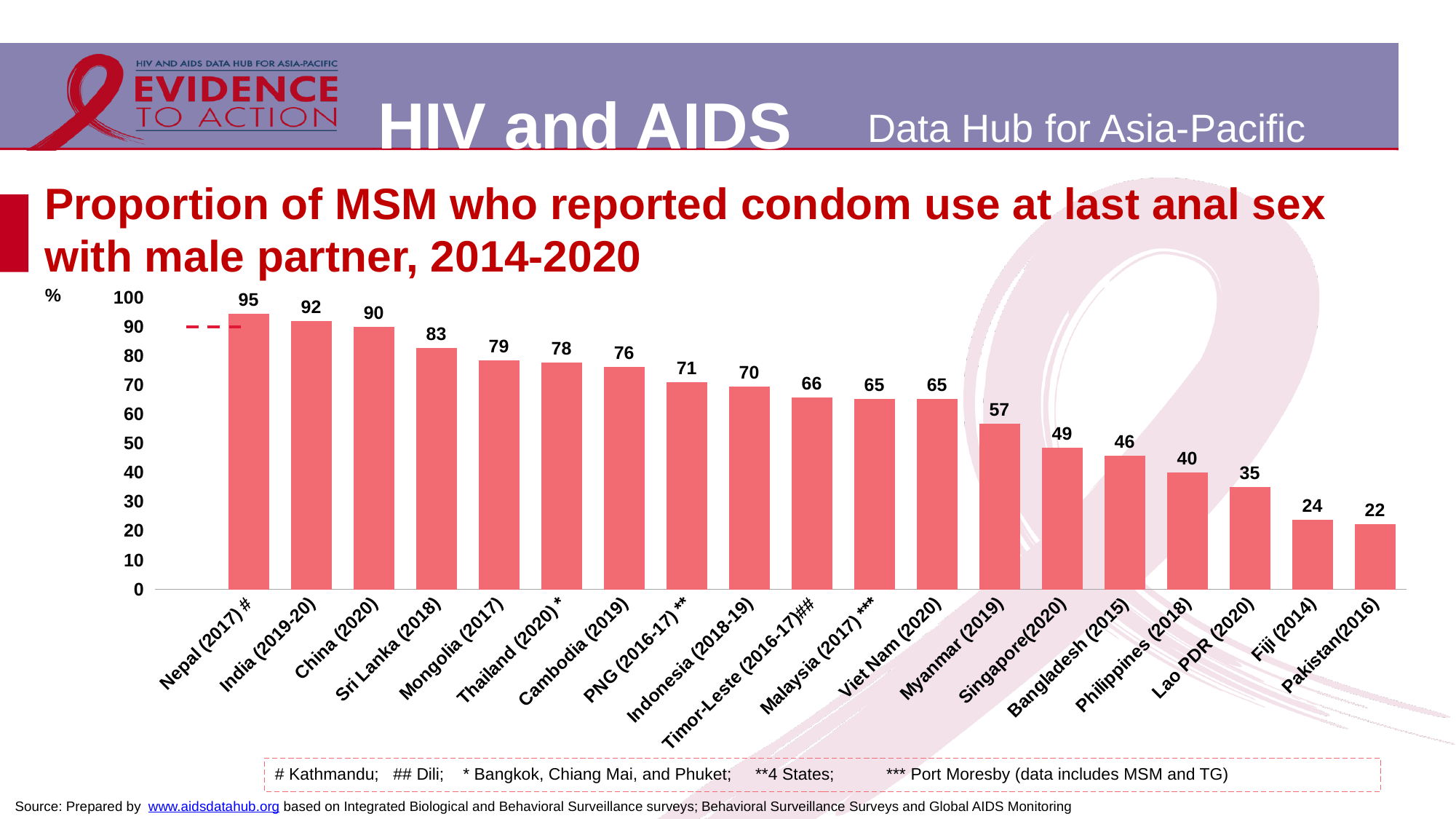
What is the difference between the values for India (2019-20) and Fiji (2014)? 68 Which country has the lowest proportion in the chart? Pakistan(2016) Which country has the highest proportion in the chart? Nepal (2017) What is the value for Philippines (2018)? 40 Which is larger, the value for Cambodia (2019) or the value for Indonesia (2018-19)? Cambodia (2019) How many countries are shown in the chart? 19 What unit is shown on the y axis of the chart? % What is the value for Nepal (2017)? 95 Do the values rise or fall from left to right across the chart? Fall Is the value for Singapore(2020) greater or less than 50? less What kind of chart is shown on the slide? Bar chart What is the value for Myanmar (2019)? 57